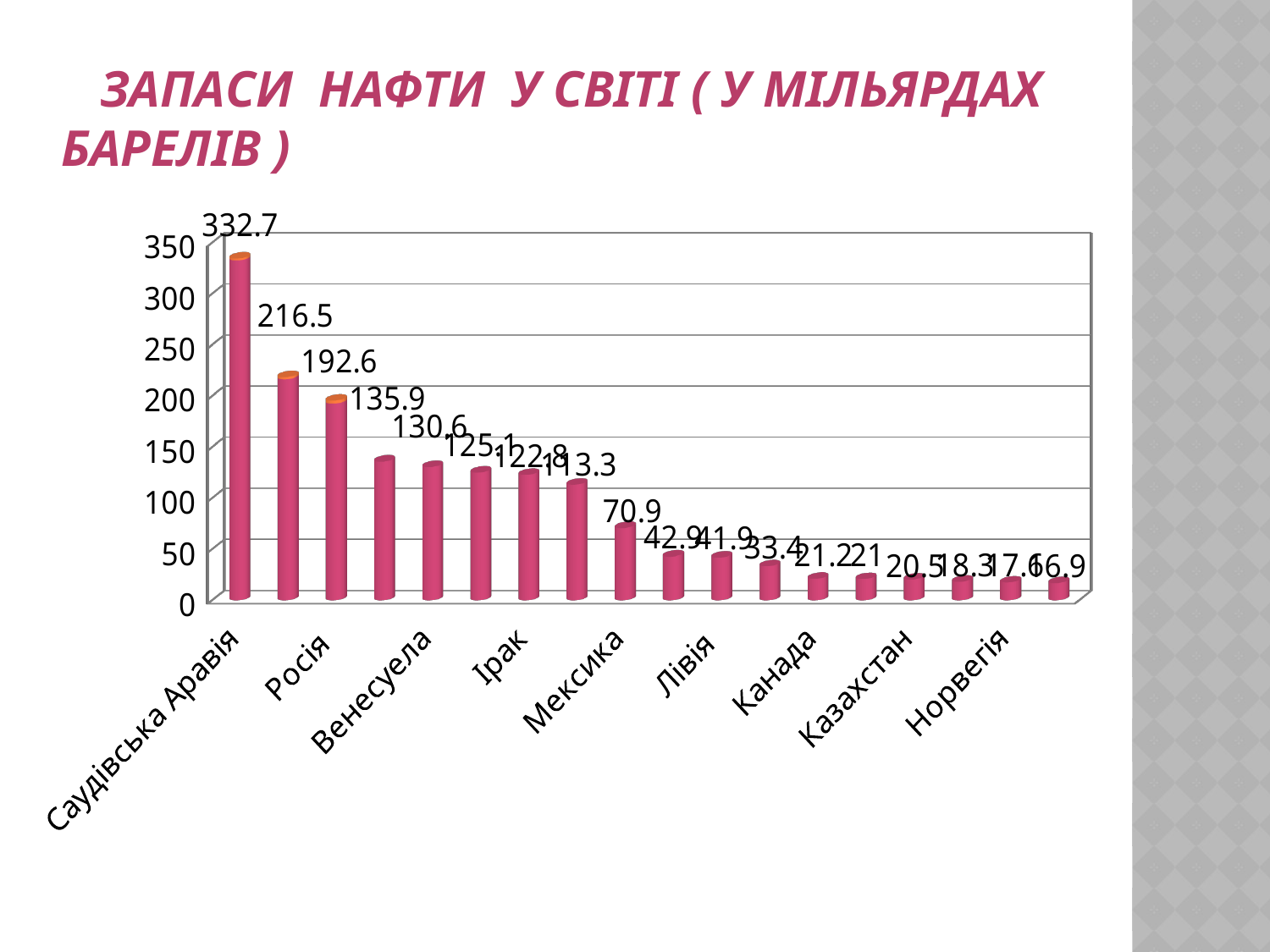
Which country has the highest oil reserves on the chart? Саудівська Аравія What is the value for Саудівська Аравія? 332.7 Is the value for Росія greater or less than 150? greater What is the value for Мексика? 70.9 Which is larger, the value for Венесуела or the value for Ірак? Венесуела How many bars are plotted on the chart? 18 What is the difference between the values for Саудівська Аравія and Росія? 140.1 What is the value for Ірак? 122.8 What is the lowest value shown on the chart? 16.9 Do the values rise or fall from left to right along the x axis? fall What kind of chart is shown on the slide? bar chart What is the value for Росія? 192.6